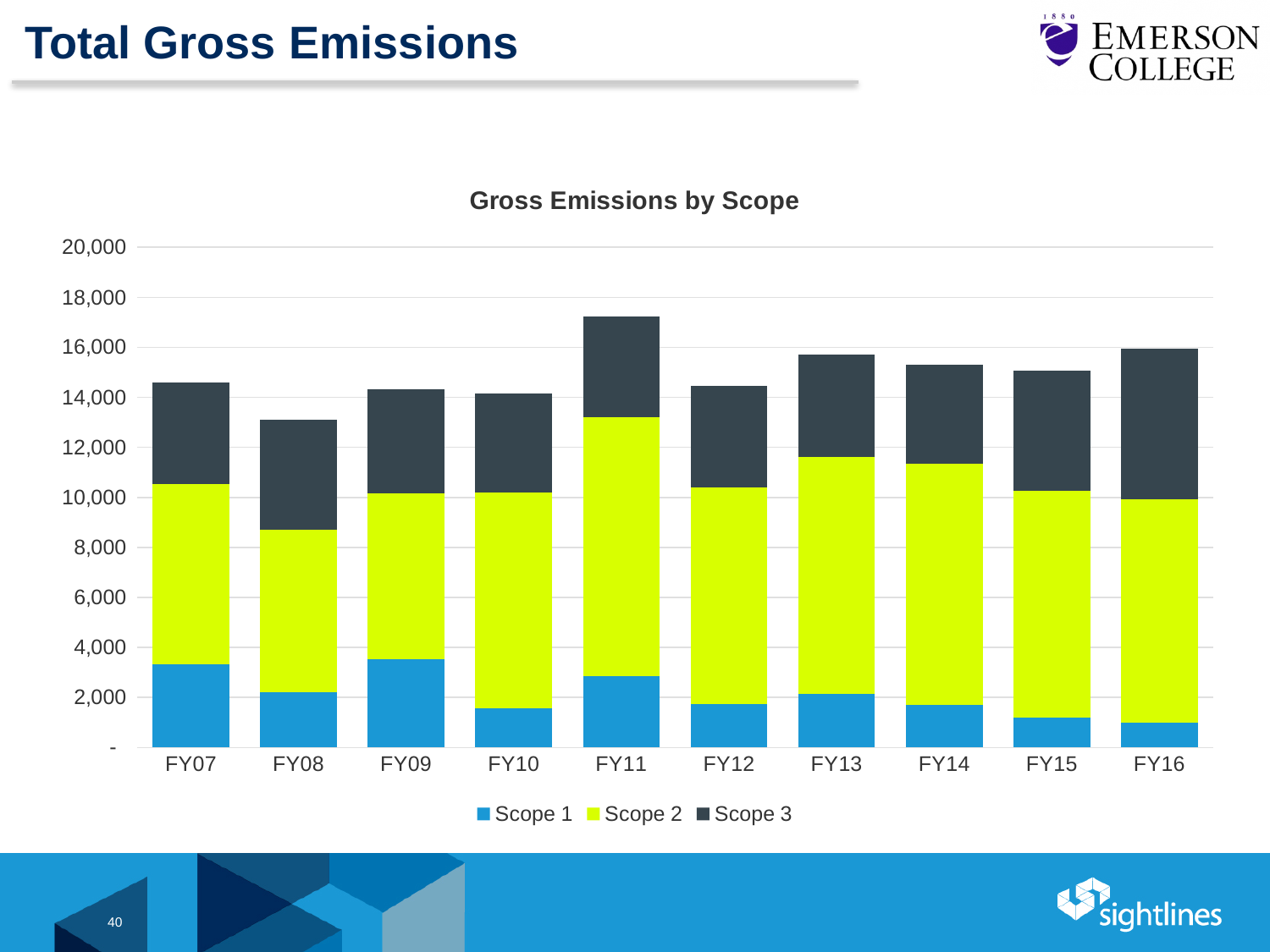
Is the total gross emissions for FY08 greater or less than 14,000? less How many fiscal years are shown on the x axis? 10 Which fiscal year has the highest total gross emissions? FY11 Is the Scope 1 value for FY10 greater or less than 2,000? less Which has the larger total gross emissions, FY13 or FY12? FY13 Which colour represents Scope 2 in the chart? Yellow-green How many series does the legend list? 3 What is the title of the chart? Gross Emissions by Scope Is the Scope 1 value for FY07 greater or less than 2,000? greater What kind of chart is shown on the slide? Stacked bar chart Which fiscal year has the lowest total gross emissions? FY08